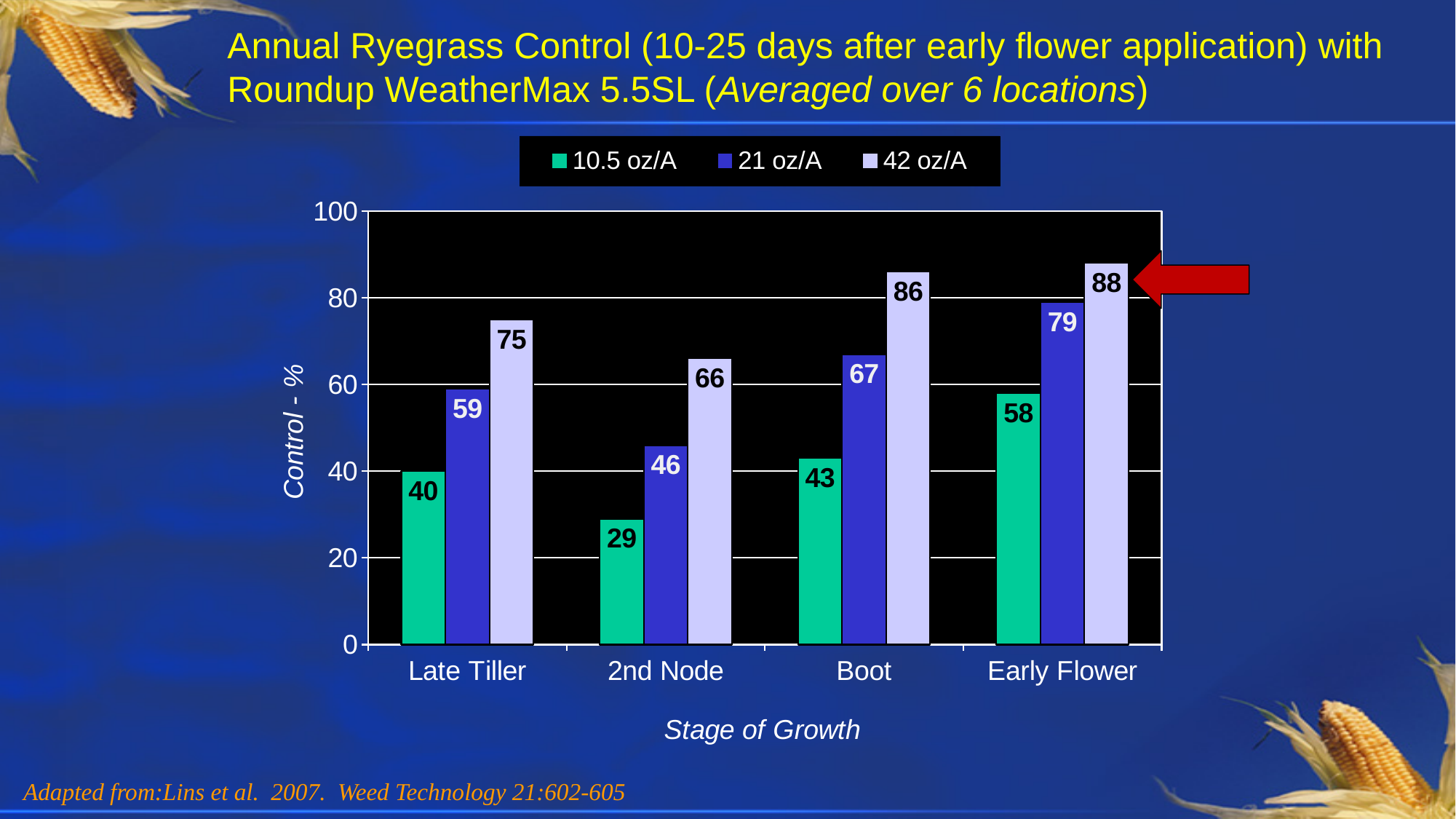
What is the control value for the 42 oz/A rate at the Boot stage? 86 What is the control value for the 10.5 oz/A rate at the 2nd Node stage? 29 How many series does the legend list? 3 Which is larger: the 21 oz/A value at Boot or the 42 oz/A value at 2nd Node? 21 oz/A at Boot What kind of chart is shown on the slide? Bar chart Which stage of growth has the highest control value for the 42 oz/A rate? Early Flower Which stage of growth has the lowest control value for the 10.5 oz/A rate? 2nd Node How many stages of growth are shown on the x axis? 4 What is the label of the y axis? Control - % Is the 10.5 oz/A value at Early Flower greater or less than 40? greater What is the difference between the 42 oz/A and 10.5 oz/A control values at the Late Tiller stage? 35 What is the control value for the 21 oz/A rate at the Early Flower stage? 79